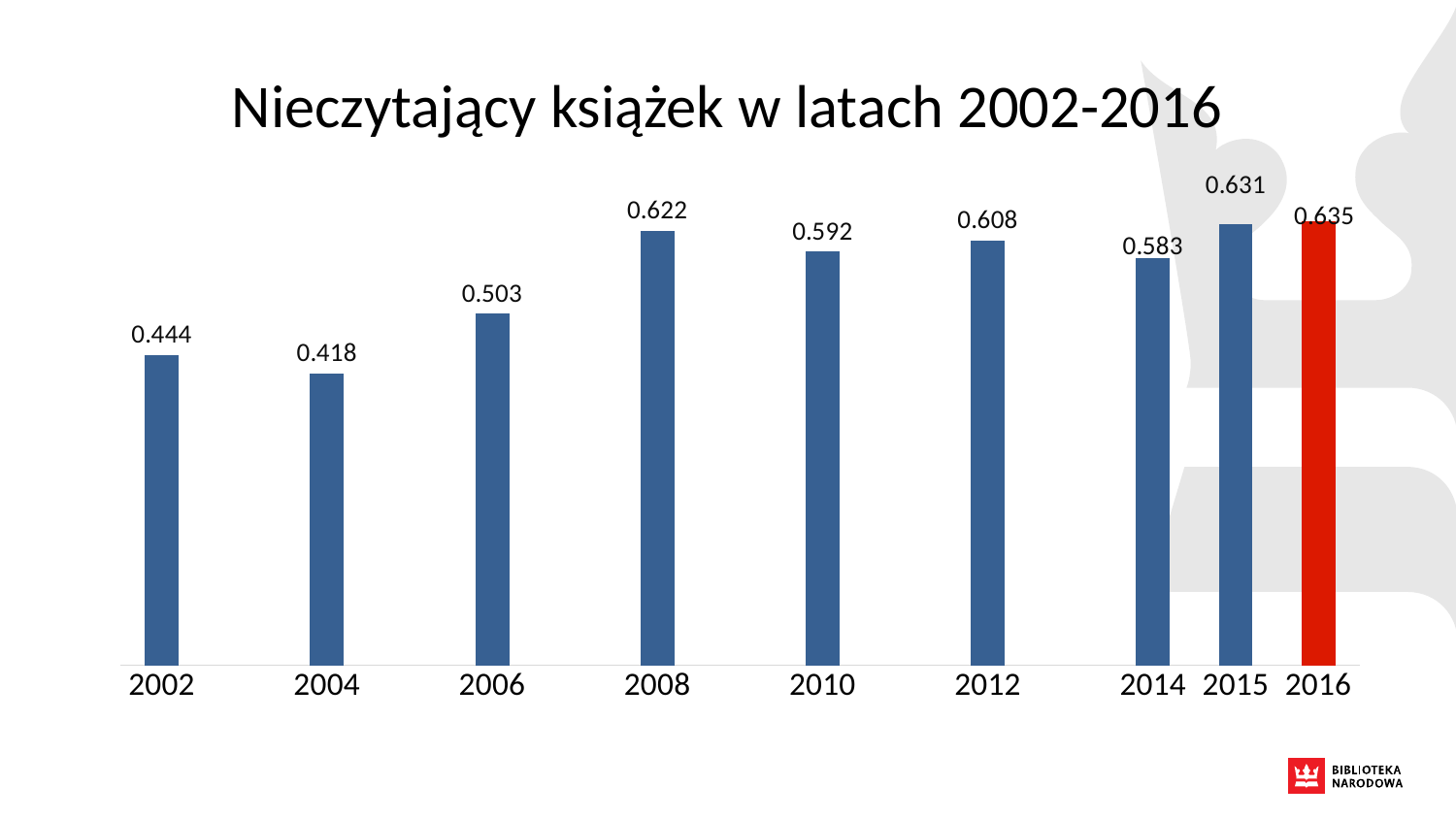
What is the difference between the values for 2008 and 2010? 0.030 What is the title of the chart? Nieczytający książek w latach 2002-2016 What kind of chart is this? bar chart What is the value for 2002? 0.444 Which is larger, the value for 2012 or the value for 2014? 2012 How many years are shown on the x axis? 9 What is the value for 2008? 0.622 What is the value for 2016? 0.635 Which year has the highest value? 2016 Which bar is coloured red instead of blue? 2016 Which year has the lowest value? 2004 What is the difference between the values for 2016 and 2002? 0.191